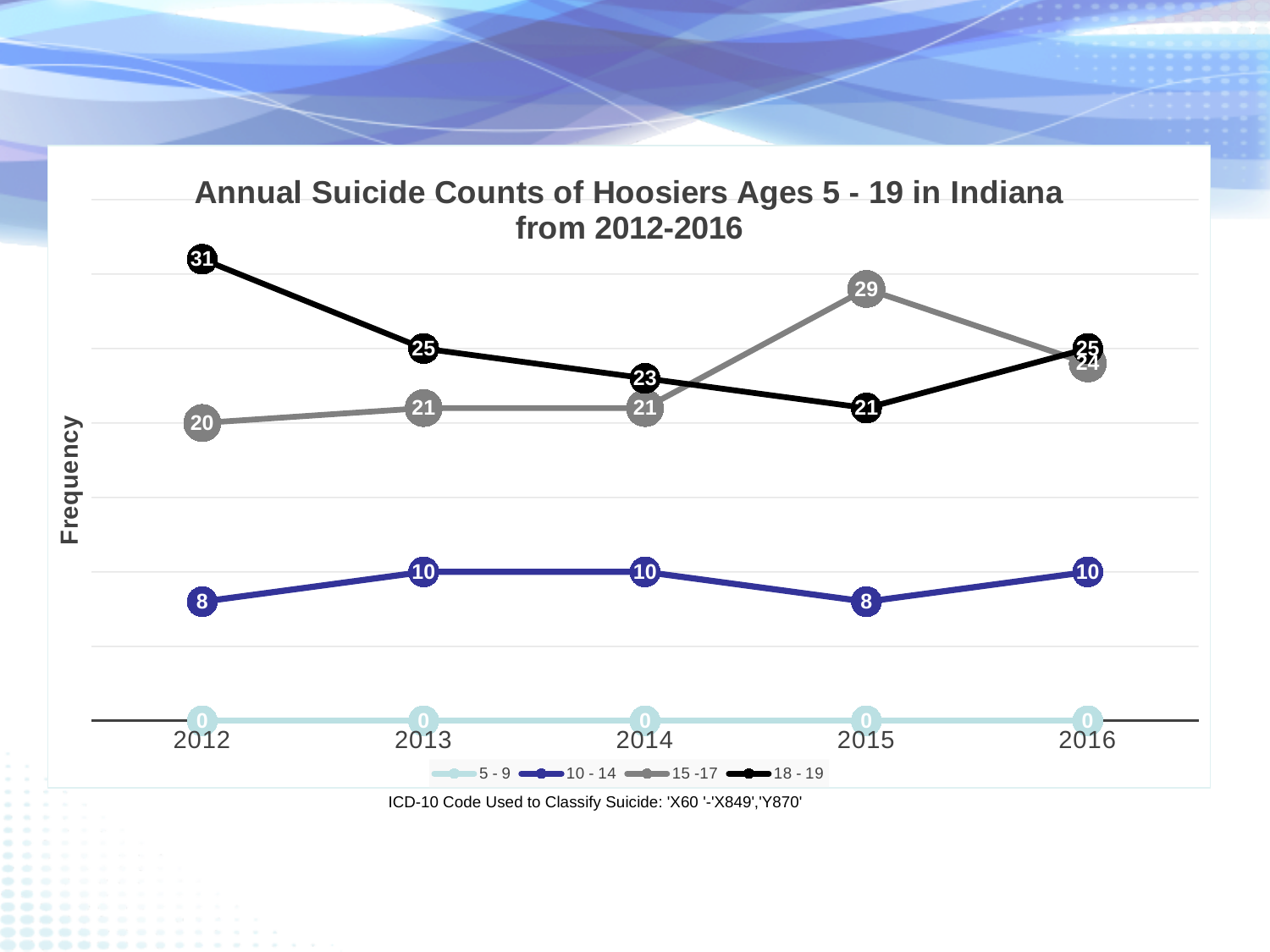
What is the difference between the 18 - 19 value in 2012 and its value in 2016? 6 Does the 18 - 19 series rise or fall from 2012 to 2015? Fall What is the value for the 15 -17 age group in 2015? 29 In which year is the value for the 15 -17 age group highest? 2015 In which year is the value for the 18 - 19 age group lowest? 2015 What is the value for the 5 - 9 age group in 2014? 0 What kind of chart is shown on the slide? Line chart How many years are plotted along the x axis? 5 How many series does the legend list? 4 Which is larger in 2015, the value for 15 -17 or the value for 18 - 19? 15 -17 What is the value for the 18 - 19 age group in 2012? 31 What is the value for the 10 - 14 age group in 2013? 10